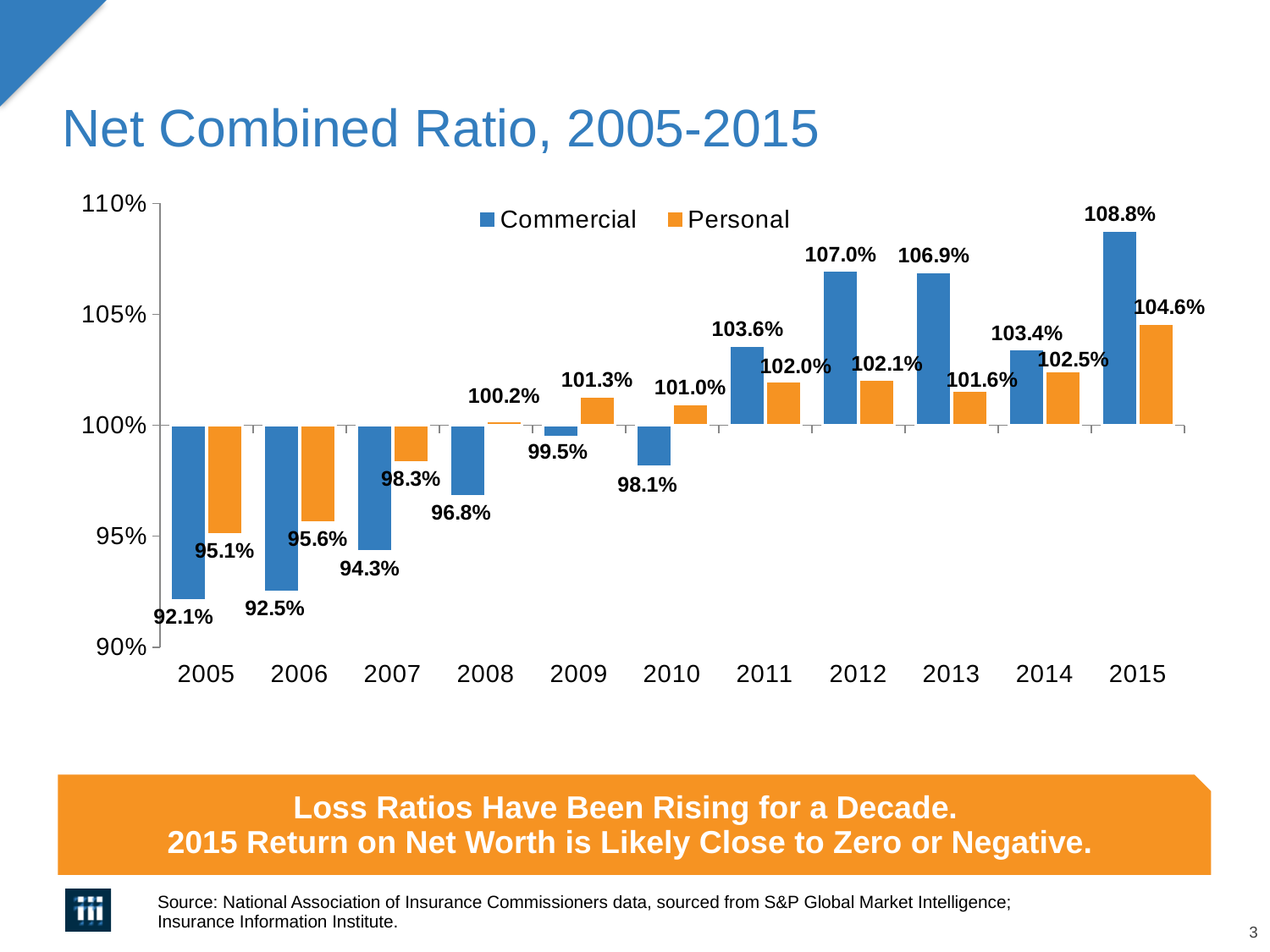
In which year is the Personal net combined ratio lowest? 2005 Which is larger in 2012, the Commercial or the Personal net combined ratio? Commercial Which is larger in 2007, the Commercial or the Personal net combined ratio? Personal What kind of chart is shown on the slide? Bar chart In which year is the Commercial net combined ratio highest? 2015 Which colour represents the Personal series? Orange What is the Commercial net combined ratio for 2015? 108.8% What is the Commercial net combined ratio for 2010? 98.1% How many series does the legend list? 2 What is the difference between the Commercial and Personal net combined ratios in 2015? 4.2% How many years are shown on the x axis? 11 What is the Personal net combined ratio for 2008? 100.2%